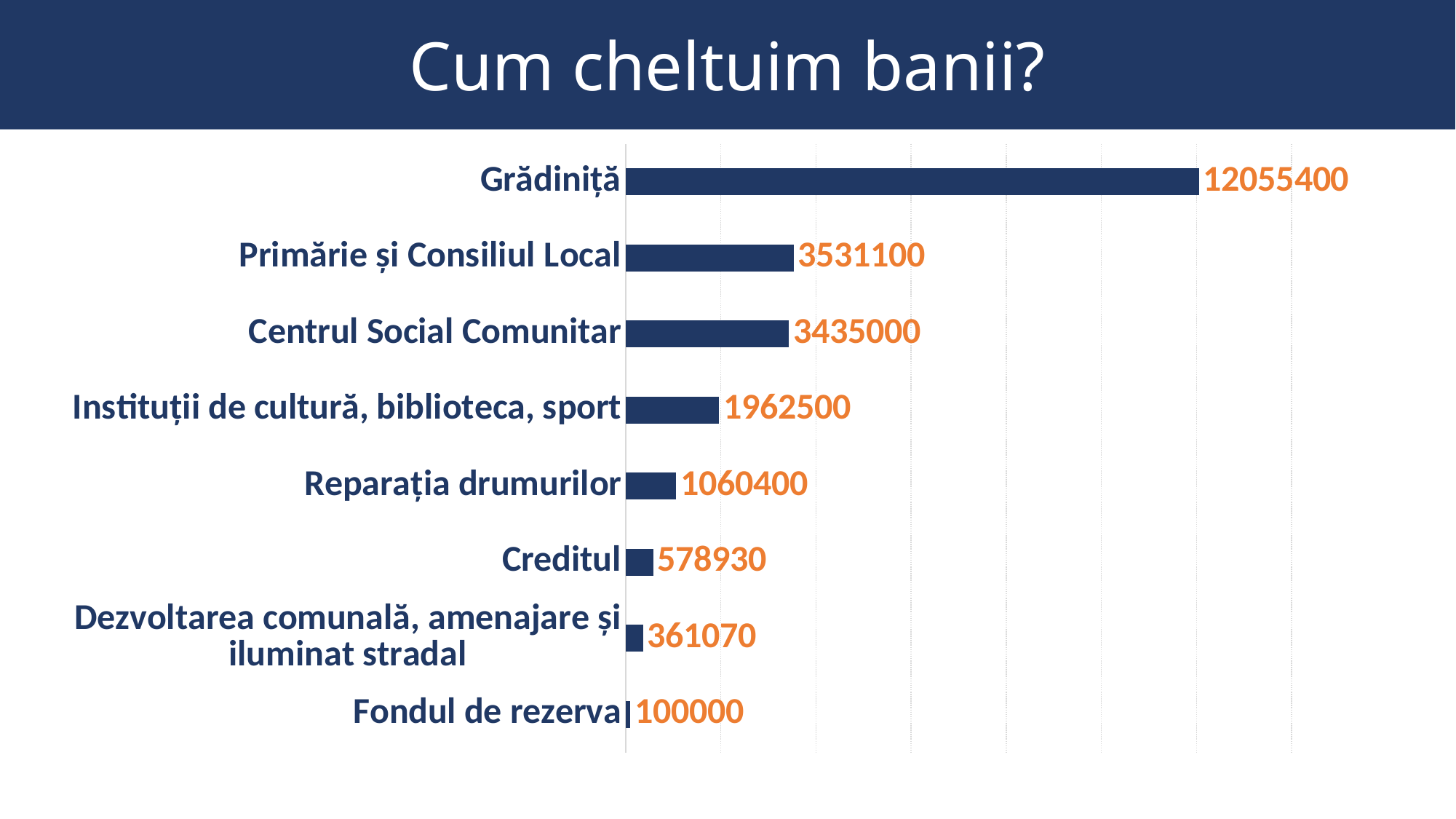
What is the value for Reparația drumurilor? 1060400 What is the difference between the values for Creditul and Dezvoltarea comunală, amenajare și iluminat stradal? 217860 What kind of chart is shown on the slide? Bar chart How many categories are shown in the chart? 8 What is the title of the slide? Cum cheltuim banii? Which category has the lowest value? Fondul de rezerva What is the value for Dezvoltarea comunală, amenajare și iluminat stradal? 361070 Which category has the highest value? Grădiniță What is the value for Grădiniță? 12055400 What is the difference between the values for Grădiniță and Primărie și Consiliul Local? 8524300 What is the value for Fondul de rezerva? 100000 Which is larger, the value for Primărie și Consiliul Local or the value for Centrul Social Comunitar? Primărie și Consiliul Local